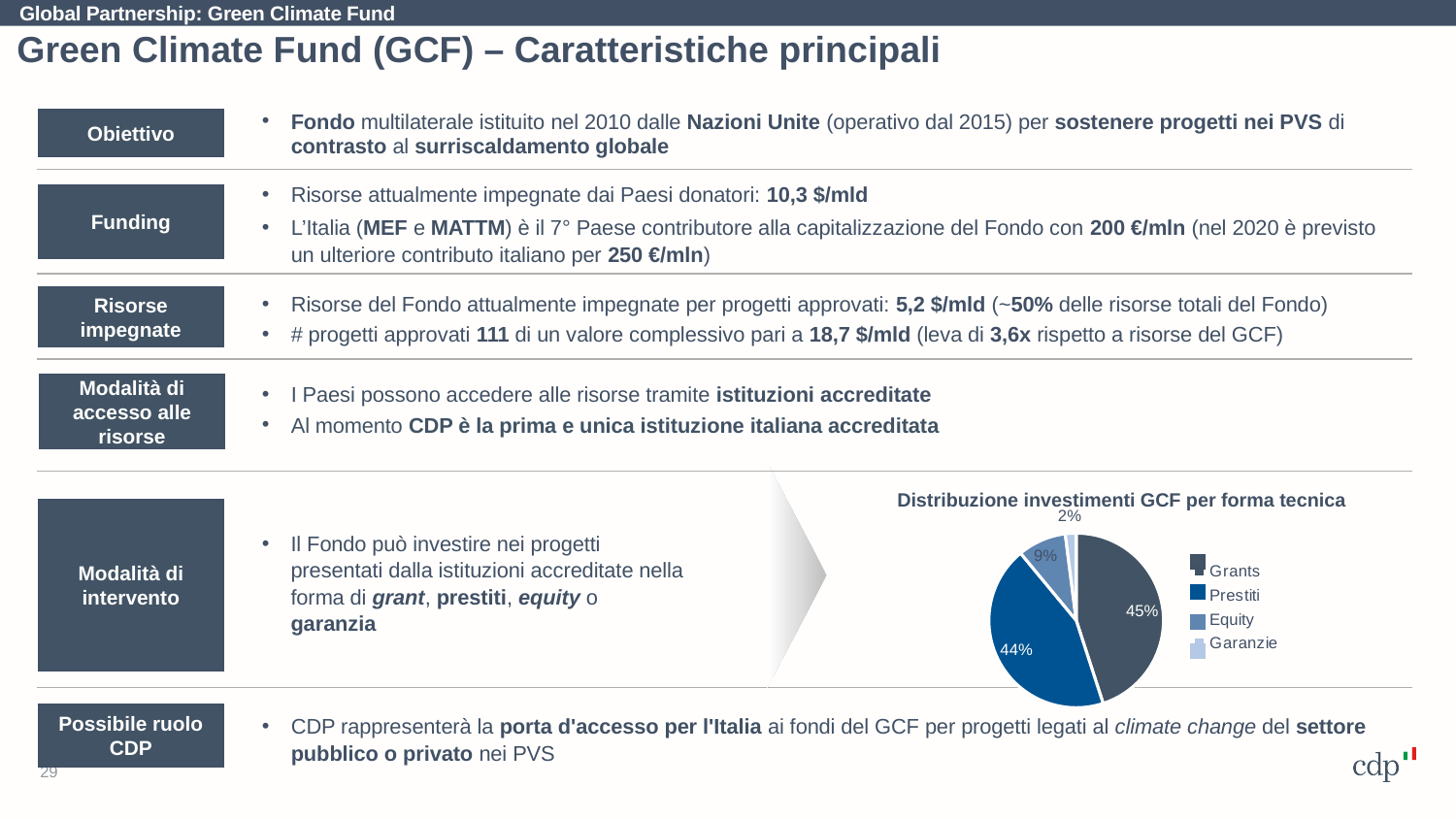
Which is larger, the Equity slice or the Garanzie slice? Equity What percentage of GCF investments is in the form of Prestiti? 44% Which form of investment has the largest share in the pie chart? Grants What is the difference in percentage points between the Grants and Prestiti slices? 1 percentage point What share of the pie does Equity represent? 9% What percentage of GCF investments is in the form of Grants? 45% How many entries does the chart legend list? 4 What is the title of the chart on the slide? Distribuzione investimenti GCF per forma tecnica Which form of investment has the smallest share in the pie chart? Garanzie What type of chart is shown on the slide? pie chart How many slices does the pie chart have? 4 What share of the pie does Garanzie represent? 2%